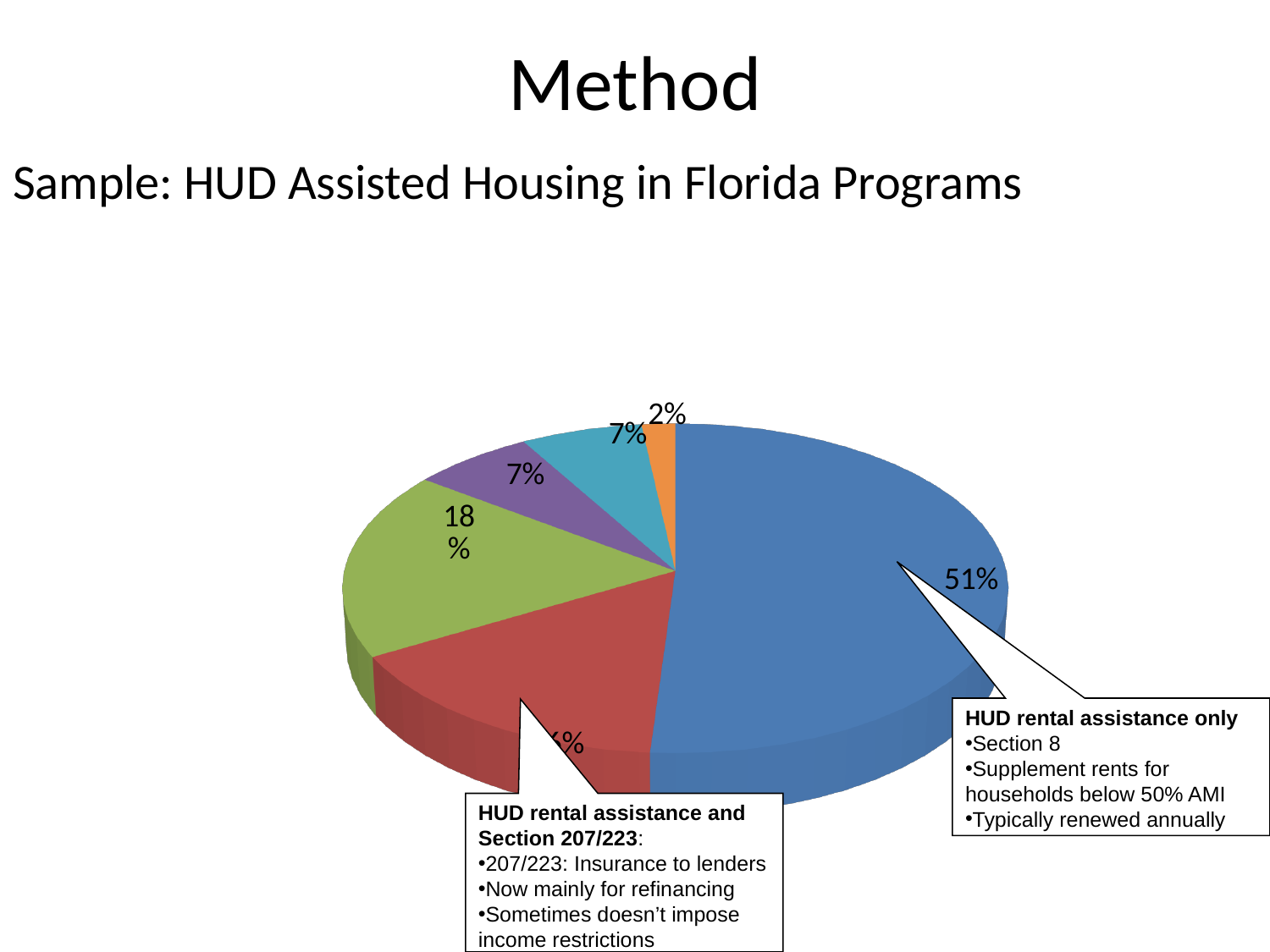
How many slices does the pie chart have? 6 What colour is the "HUD rental assistance only" slice? Blue What kind of chart is shown on the slide? Pie chart What share of the pie is labeled "HUD rental assistance only"? 51% How many slices of the pie are labeled 7%? 2 What is the sample described in the subtitle above the chart? HUD Assisted Housing in Florida Programs Which slice is larger: "HUD rental assistance only" or "HUD rental assistance and Section 207/223"? HUD rental assistance only What is the difference in percentage points between the 51% slice and the 18% slice? 33 Is the share for "HUD rental assistance only" greater or less than 50%? greater Which category has the largest slice of the pie? HUD rental assistance only What is the smallest percentage shown on the pie chart? 2%